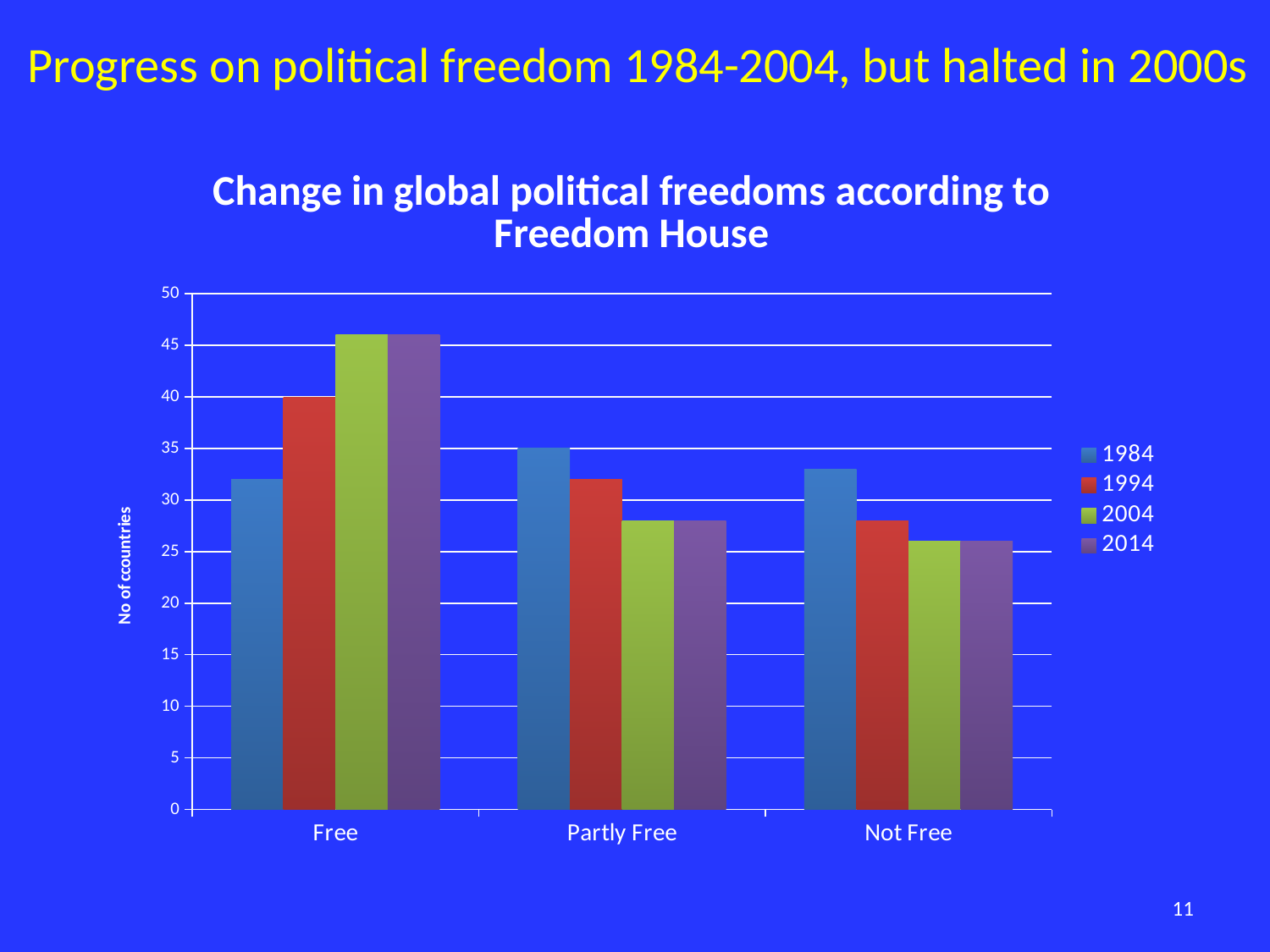
What is the title of the chart? Change in global political freedoms according to Freedom House Is the value for 2004 in the Free category greater or less than 40? greater Is the value for 2014 in the Not Free category greater or less than 30? less What is the label on the vertical axis? No of ccountries Which is larger, the 2014 value for Free or the 2014 value for Not Free? Free Which year has the highest value in the Not Free category? 1984 Do the bars for the Free category rise or fall from 1984 to 2014? rise Is the value for 1984 in the Partly Free category greater or less than 30? greater How many categories are shown on the x axis? 3 Which year has the lowest value in the Free category? 1984 What kind of chart is shown on the slide? Bar chart How many series does the legend list? 4